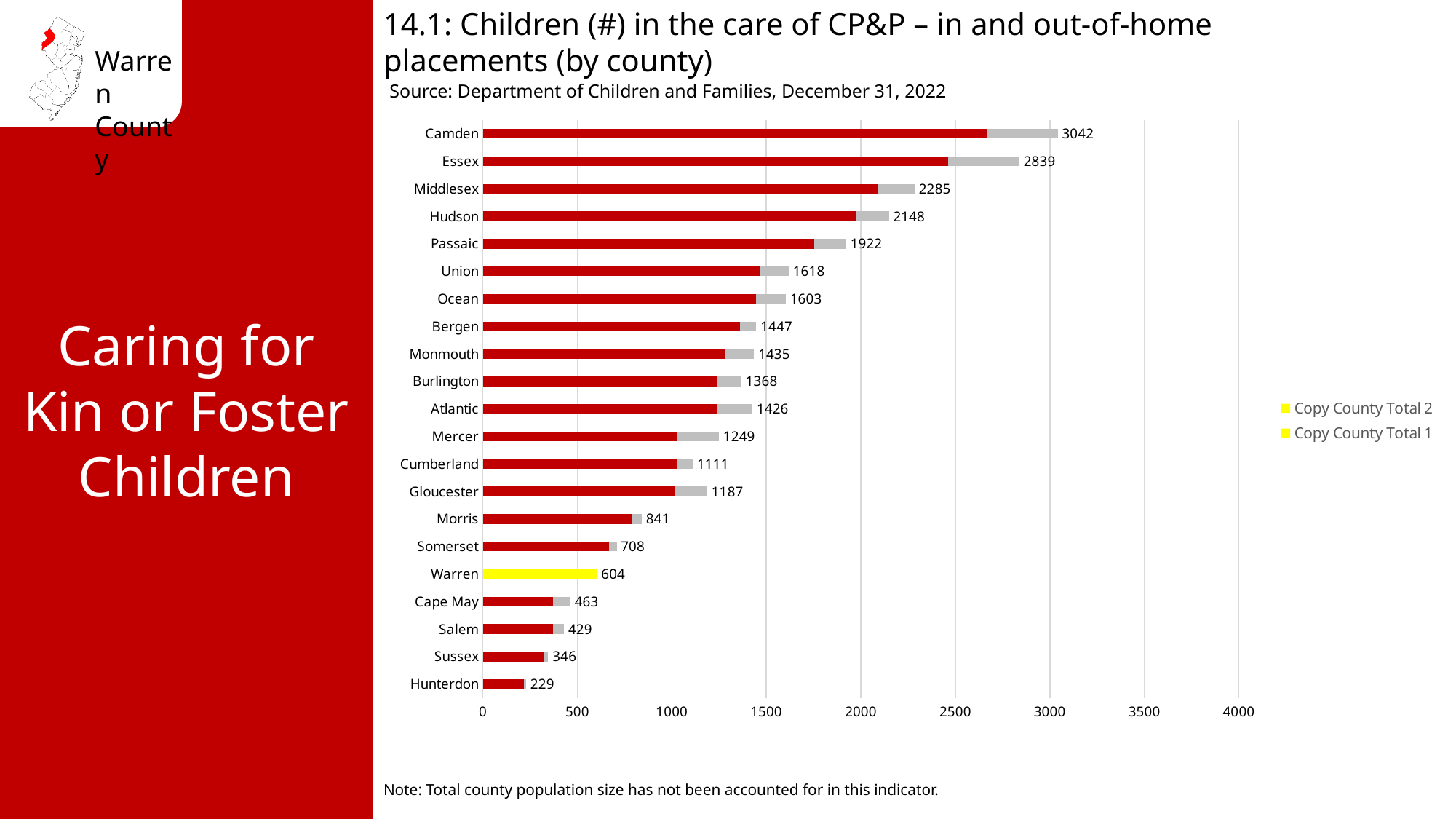
How many counties are shown on the chart? 21 What value is labeled for Warren County? 604 How many series does the legend list? 2 Is the labeled total for Passaic greater or less than 2000? less What is the total number of children in the care of CP&P shown for Camden? 3042 What kind of chart is shown on the slide? Bar chart Which county's bar is highlighted in yellow? Warren Which county has the highest labeled total? Camden What value is labeled for Hunterdon? 229 Which county has the lowest labeled total? Hunterdon What is the difference between the labeled totals for Camden and Essex? 203 Which has a larger labeled total, Atlantic or Burlington? Atlantic